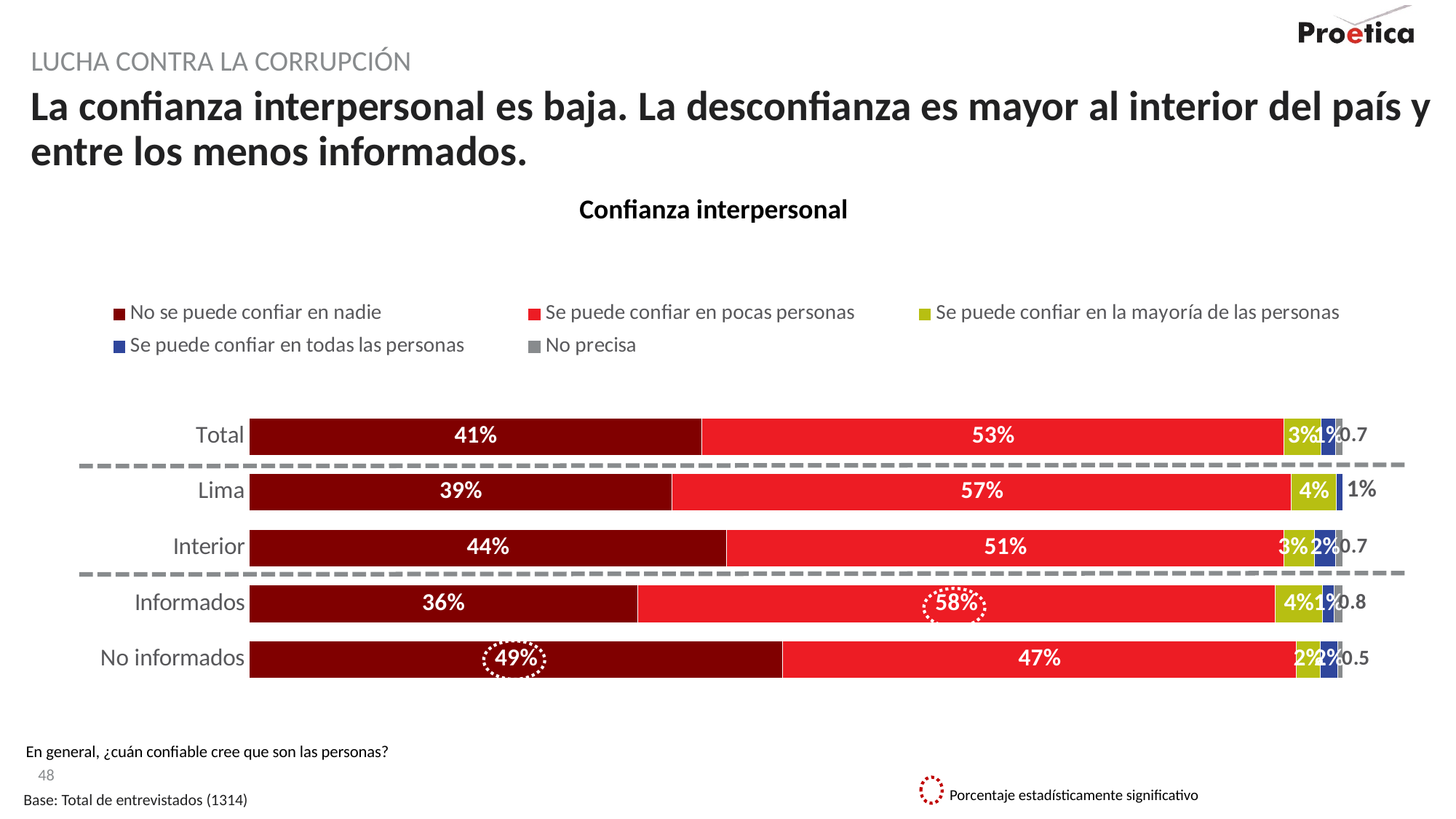
Which is larger: 'Se puede confiar en pocas personas' for Informados or for No informados? Informados What is the difference between the 'No se puede confiar en nadie' values for Interior and Lima? 5% Which category has the highest value for 'No se puede confiar en nadie'? No informados How many series does the legend list? 5 What is the value of 'No se puede confiar en nadie' for Total? 41% How many categories are shown on the chart? 5 What is the value of 'No se puede confiar en nadie' for No informados? 49% Which category has the lowest value for 'No se puede confiar en nadie'? Informados What is the value of 'Se puede confiar en la mayoría de las personas' for Informados? 4% What is the title of the chart? Confianza interpersonal What is the value of 'Se puede confiar en pocas personas' for Lima? 57% What type of chart is shown on the slide? Stacked bar chart